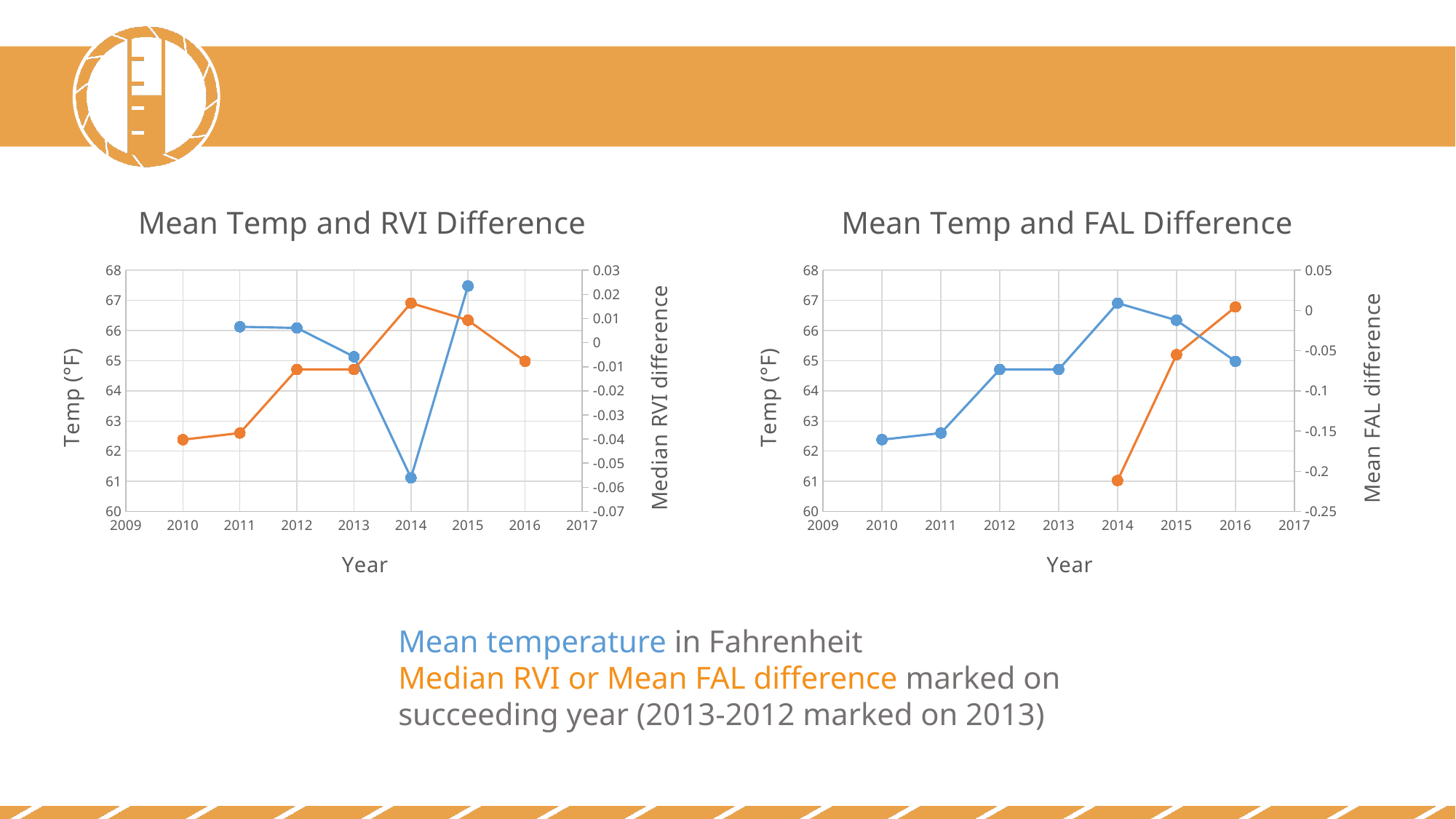
In the 'Mean Temp and FAL Difference' chart, is the Mean FAL difference for 2014 greater or less than -0.15? less In the 'Mean Temp and RVI Difference' chart, is the temperature for 2014 greater or less than 66? greater What kind of chart is the 'Mean Temp and RVI Difference' chart? line chart In the 'Mean Temp and RVI Difference' chart, which year has the higher temperature, 2014 or 2016? 2014 In the 'Mean Temp and FAL Difference' chart, how many points does the Mean FAL difference series have? 3 In the 'Mean Temp and RVI Difference' chart, how many years have a temperature point plotted? 7 In the 'Mean Temp and RVI Difference' chart, which year has the highest temperature? 2014 In the 'Mean Temp and RVI Difference' chart, how many points does the Median RVI difference series have? 5 In the 'Mean Temp and RVI Difference' chart, is the Median RVI difference for 2014 greater or less than -0.05? less What is the title of the right-hand vertical axis in the 'Mean Temp and RVI Difference' chart? Median RVI difference In the 'Mean Temp and FAL Difference' chart, does the Mean FAL difference rise or fall from 2014 to 2016? rise In the 'Mean Temp and RVI Difference' chart, which year has the lowest Median RVI difference? 2014